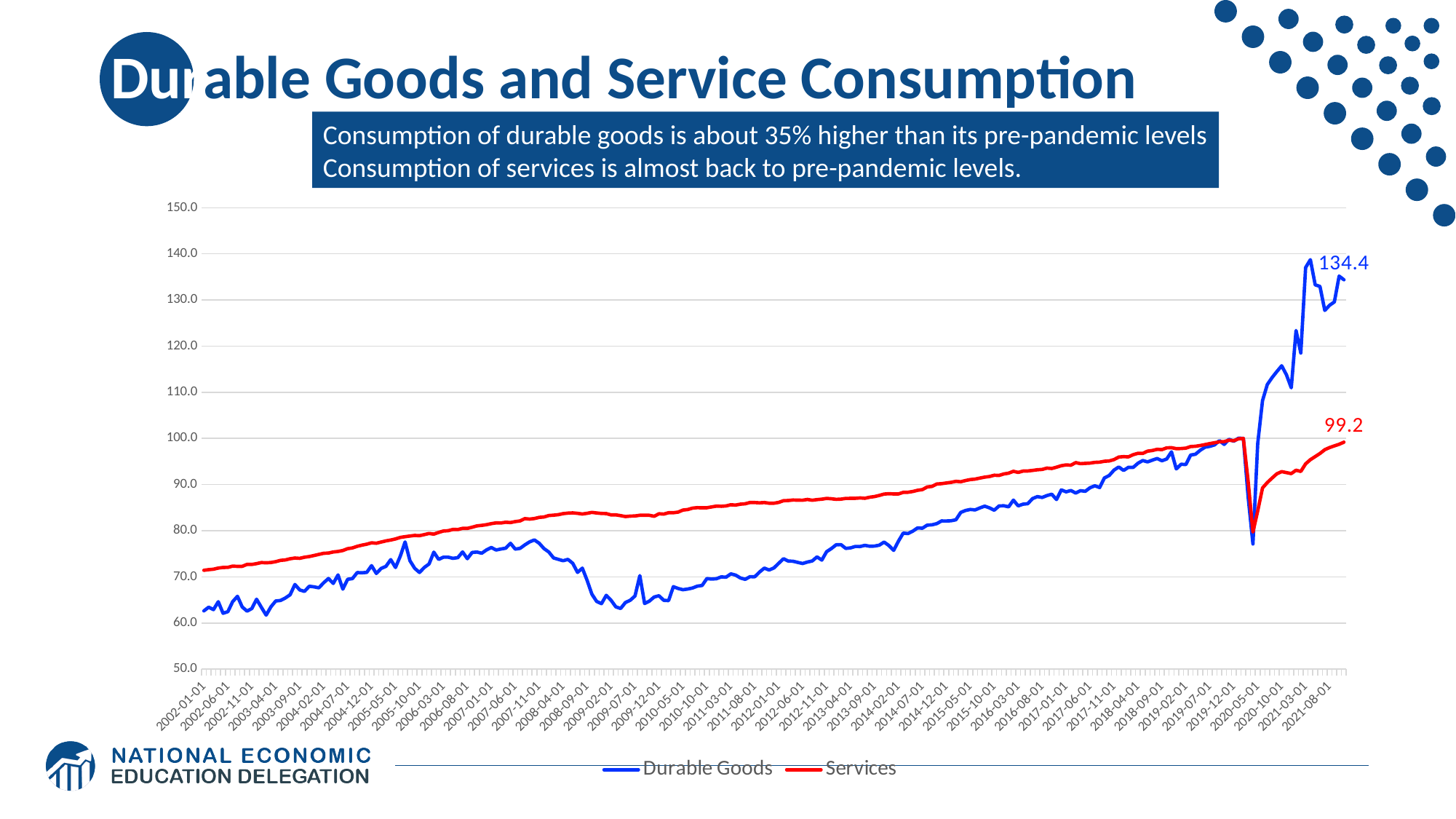
At the end of the chart, which series has the higher value, Durable Goods or Services? Durable Goods Is the value for Durable Goods at 2002-01-01 greater or less than 70? less What is the final labelled value of the Services series? 99.2 What is the final labelled value of the Durable Goods series? 134.4 How many series does the legend list? 2 Is the value for Services at its 2020 dip greater or less than 90? less Is the value for Services at 2002-01-01 greater or less than 80? less What is the difference between the final labelled values of Durable Goods and Services? 35.2 Around 2009, which series has the higher value, Durable Goods or Services? Services What colour is the Services line in the chart? red Does the Services series generally rise or fall from 2002 to 2019? rise What kind of chart is shown on the slide? line chart